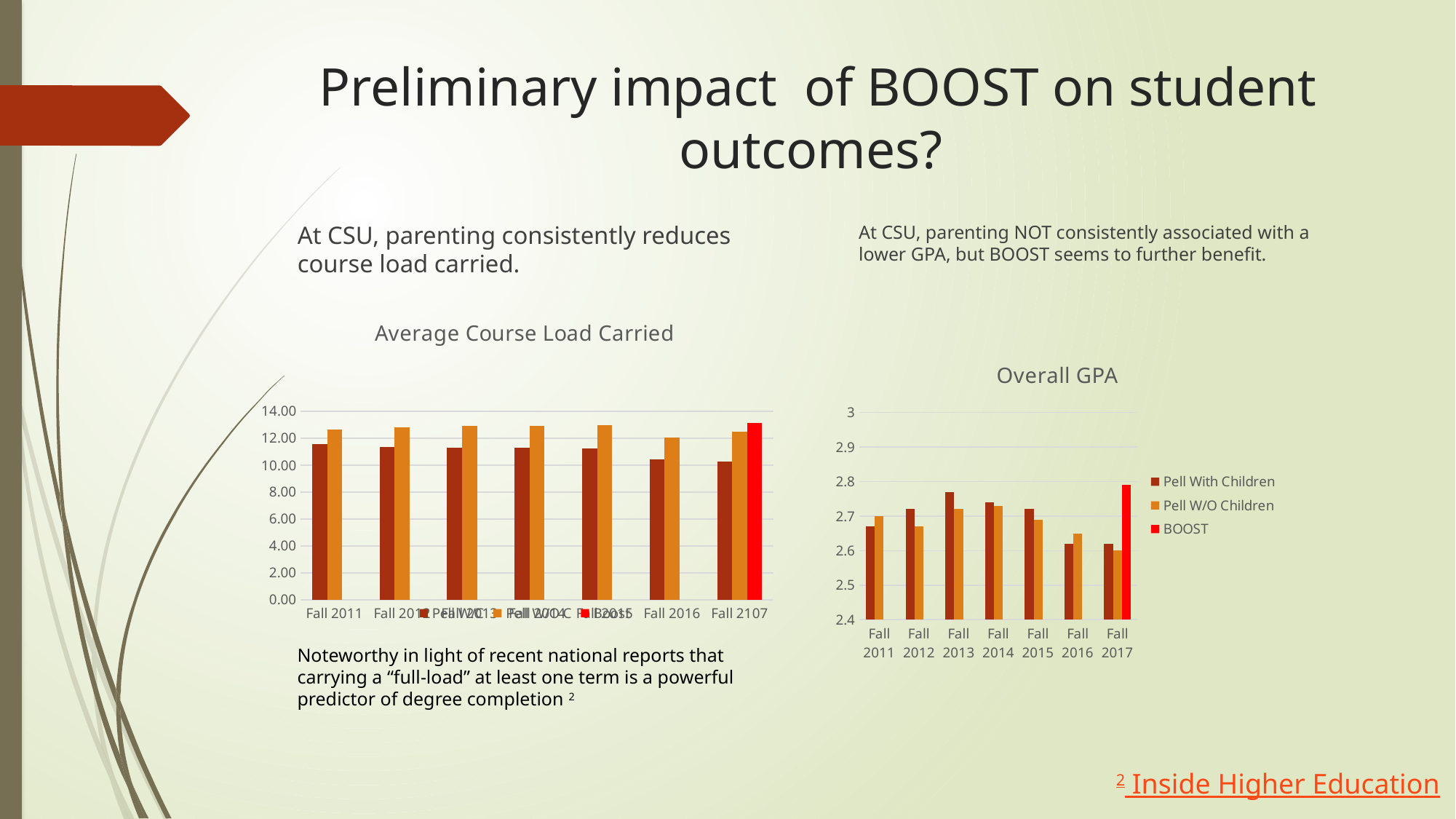
In the "Overall GPA" chart, is the BOOST value for Fall 2017 greater or less than 2.7? greater How many Fall terms are shown on the x axis of the "Overall GPA" chart? 7 In the "Average Course Load Carried" chart, is the value of the red bar for Fall 2107 greater or less than 12.00? greater In the "Overall GPA" chart, is the Pell W/O Children value for Fall 2017 greater or less than 2.7? less In the "Overall GPA" chart, for Fall 2013, which is larger: Pell With Children or Pell W/O Children? Pell With Children In the "Overall GPA" chart, which series is shown in red? BOOST How many Fall terms are shown on the x axis of the "Average Course Load Carried" chart? 7 In the "Average Course Load Carried" chart, do the dark (first) bars generally rise or fall from Fall 2011 to Fall 2107? fall What kind of chart is the "Overall GPA" chart? bar chart In the "Overall GPA" chart, which bar is the highest? BOOST in Fall 2017 How many series does the legend of the "Overall GPA" chart list? 3